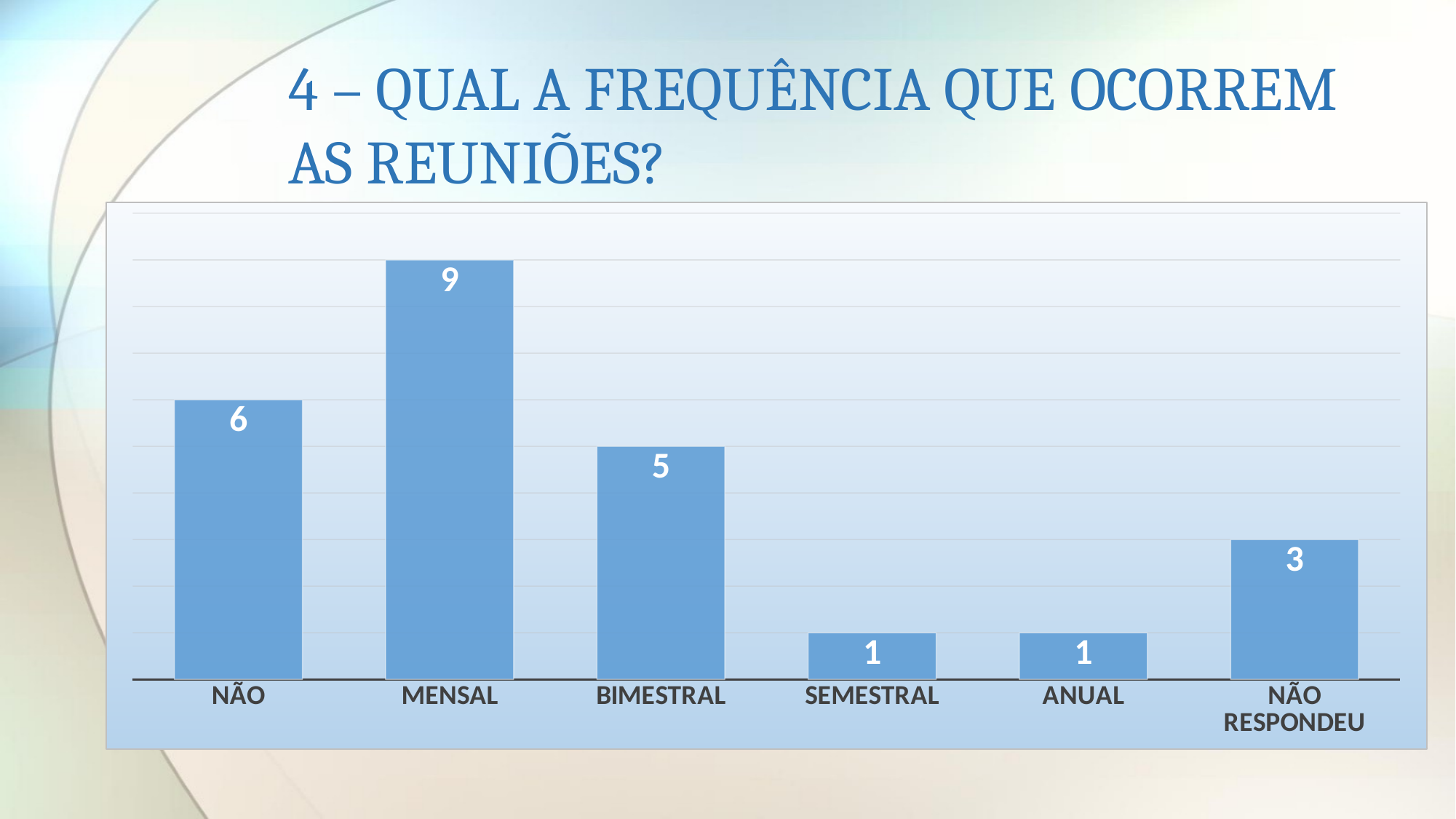
Which is larger, the value for NÃO or the value for BIMESTRAL? NÃO What is the value for NÃO RESPONDEU? 3 What is the difference between the values for BIMESTRAL and NÃO RESPONDEU? 2 What is the value for NÃO? 6 What kind of chart is shown on the slide? Bar chart What is the value for BIMESTRAL? 5 What is the difference between the values for MENSAL and NÃO? 3 What is the value for MENSAL? 9 How many categories are shown on the x axis? 6 What is the value for SEMESTRAL? 1 What is the title of the slide? 4 – QUAL A FREQUÊNCIA QUE OCORREM AS REUNIÕES? Which category has the highest value? MENSAL